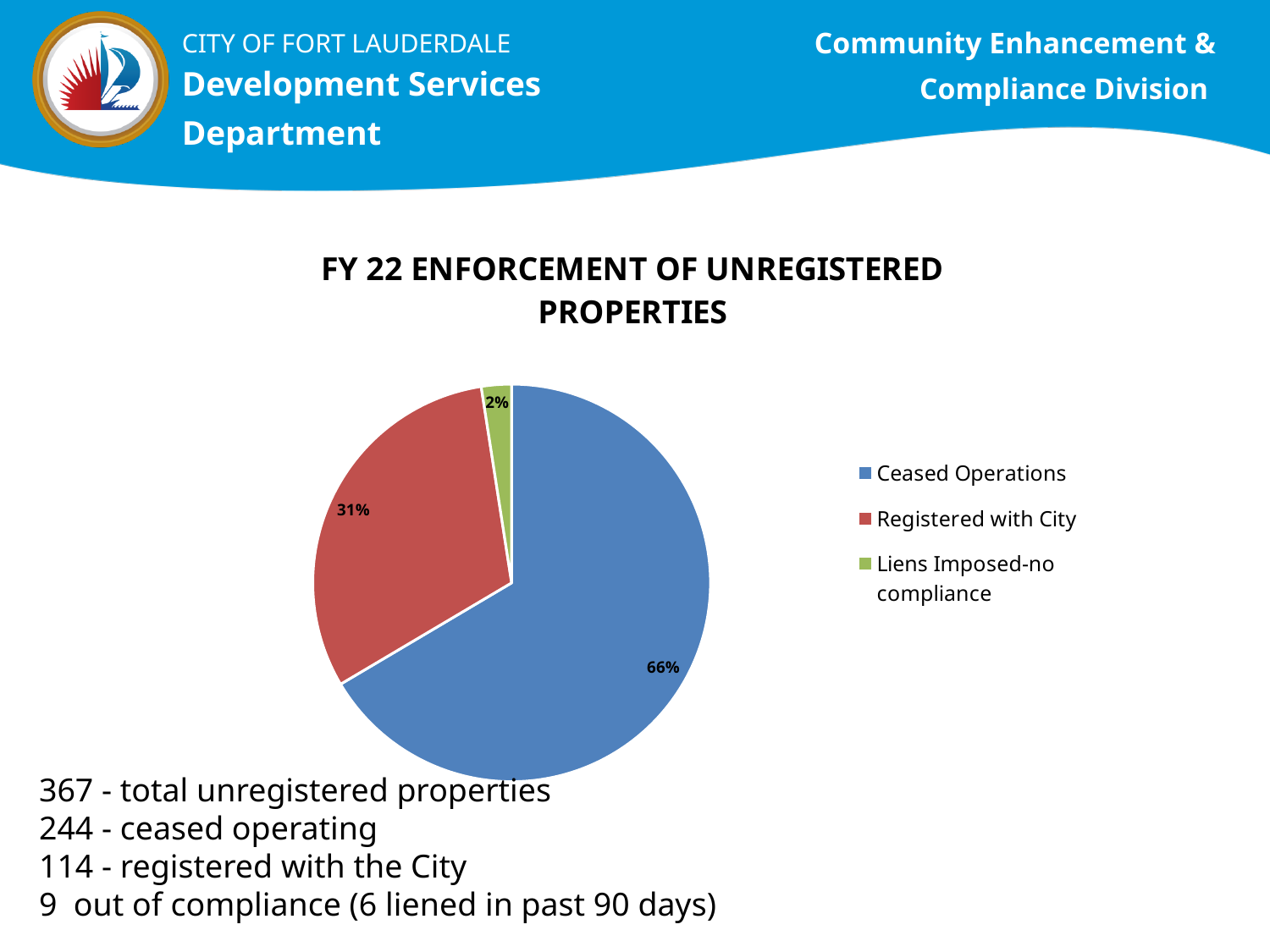
How many slices does the pie chart have? 3 What is the title of the chart? FY 22 ENFORCEMENT OF UNREGISTERED PROPERTIES What share of the pie is Ceased Operations? 66% What is the difference in percentage points between the Ceased Operations slice and the Registered with City slice? 35 What kind of chart is shown on the slide? pie chart Which category has the largest slice of the pie? Ceased Operations What share of the pie is Liens Imposed-no compliance? 2% Which category has the smallest slice of the pie? Liens Imposed-no compliance How many entries does the legend list? 3 What share of the pie is Registered with City? 31% Which is larger, the Registered with City slice or the Liens Imposed-no compliance slice? Registered with City What colour is the Registered with City slice? red